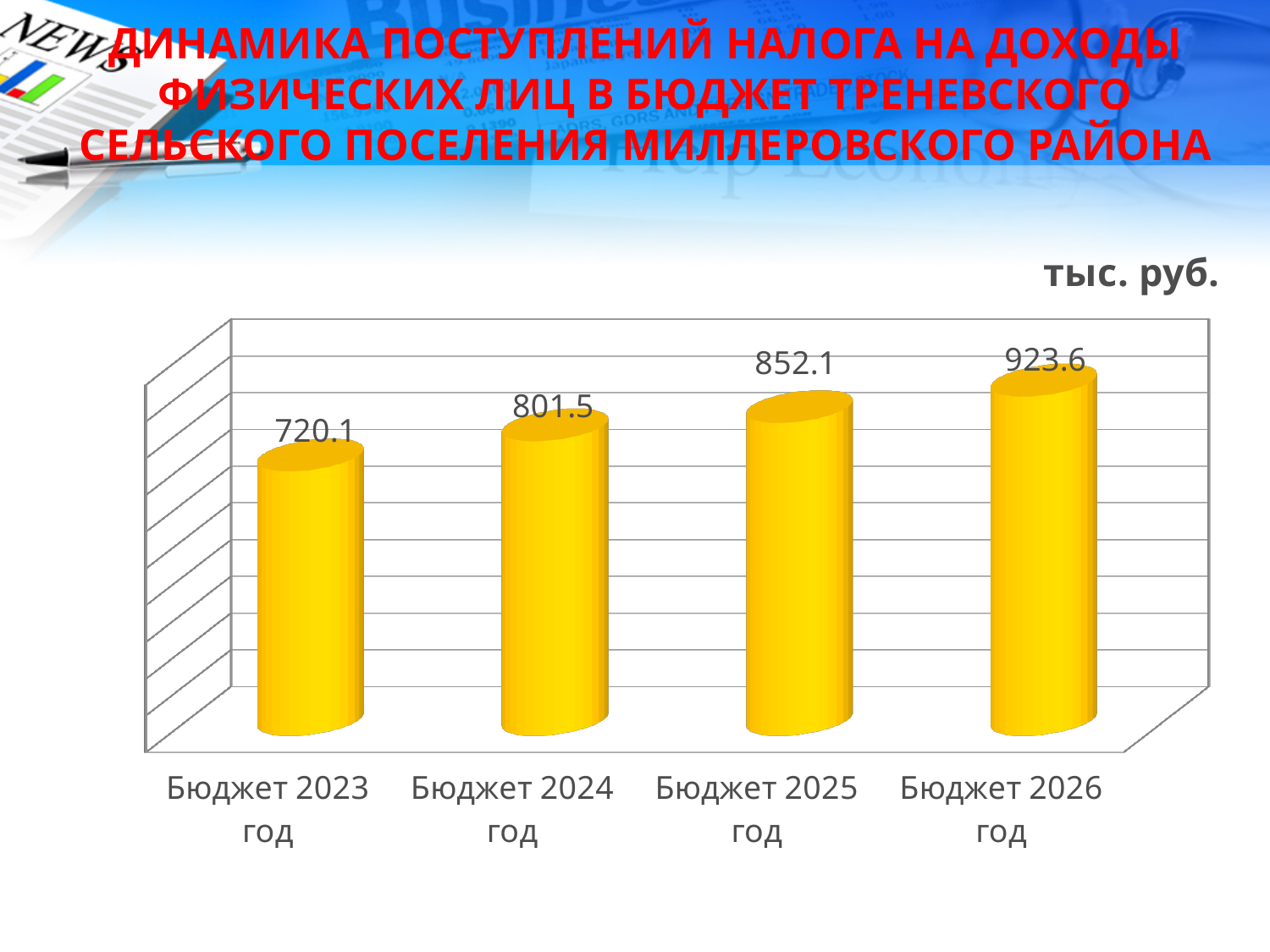
Which category has the lowest value? Бюджет 2023 год How many categories are shown on the chart? 4 What kind of chart is shown on the slide? Bar chart What is the difference between the values for Бюджет 2026 год and Бюджет 2023 год? 203.5 What is the difference between the values for Бюджет 2025 год and Бюджет 2024 год? 50.6 Which category has the highest value? Бюджет 2026 год Do the values rise or fall from Бюджет 2023 год to Бюджет 2026 год? Rise What is the value for Бюджет 2025 год? 852.1 Which is larger, the value for Бюджет 2024 год or Бюджет 2025 год? Бюджет 2025 год What is the value for Бюджет 2023 год? 720.1 What is the value for Бюджет 2024 год? 801.5 What is the value for Бюджет 2026 год? 923.6